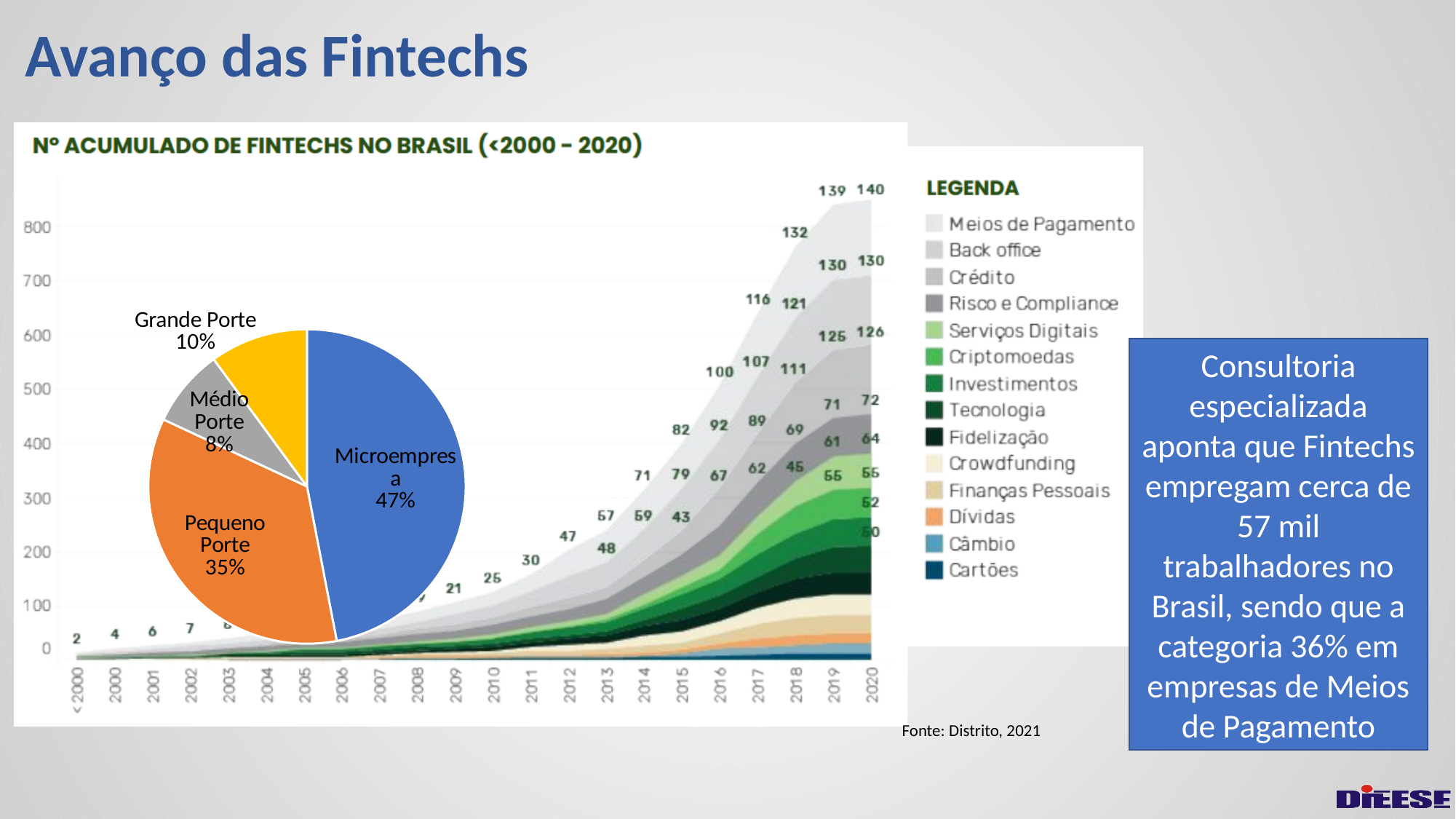
In the pie chart, what share is labelled for Pequeno Porte? 35% In the area chart, does the accumulated number of fintechs rise or fall from 2000 to 2020? rise What is the title of the area chart on the slide? Nº ACUMULADO DE FINTECHS NO BRASIL (<2000 – 2020) How many entries does the legend (LEGENDA) of the area chart list? 14 In the pie chart, what share is labelled for Médio Porte? 8% In the pie chart, what share is labelled for Microempresa? 47% In the pie chart, which category has the smallest slice? Médio Porte How many categories does the pie chart show? 4 In the pie chart, what share is labelled for Grande Porte? 10% In the pie chart, which is larger: Grande Porte or Médio Porte? Grande Porte In the pie chart, which category has the largest slice? Microempresa In the pie chart, what is the difference in percentage points between Microempresa and Pequeno Porte? 12